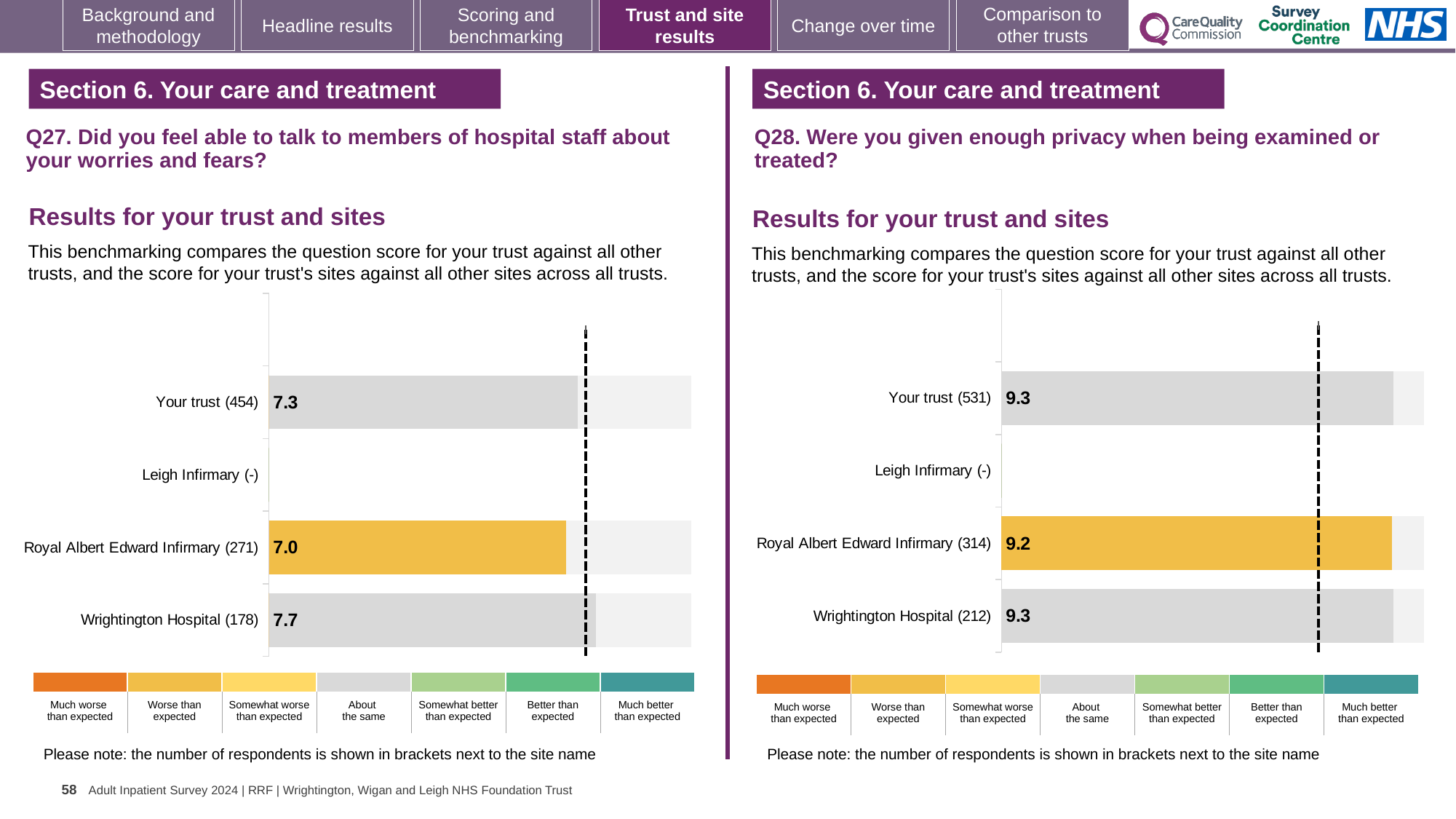
In the Q28 chart on the right, how many respondents are shown in brackets for Your trust? 531 In the Q28 chart on the right, which is larger, the score for Wrightington Hospital or the score for Royal Albert Edward Infirmary? Wrightington Hospital In the Q27 chart on the left, which site has the lowest score? Royal Albert Edward Infirmary In the Q27 chart on the left, what is the difference between the scores for Wrightington Hospital and Royal Albert Edward Infirmary? 0.7 In the Q28 chart on the right, what is the score for Your trust? 9.3 In the Q27 chart on the left, what is the score for Your trust? 7.3 In the Q27 chart on the left, what is the score for Royal Albert Edward Infirmary? 7.0 What kind of chart is used for the Q28 results on the right? Bar chart In the Q28 chart on the right, what is the score for Royal Albert Edward Infirmary? 9.2 How many site or trust rows are listed in the Q27 chart on the left? 4 In the Q27 chart on the left, what is the score for Wrightington Hospital? 7.7 In the Q27 chart on the left, which site has the highest score? Wrightington Hospital